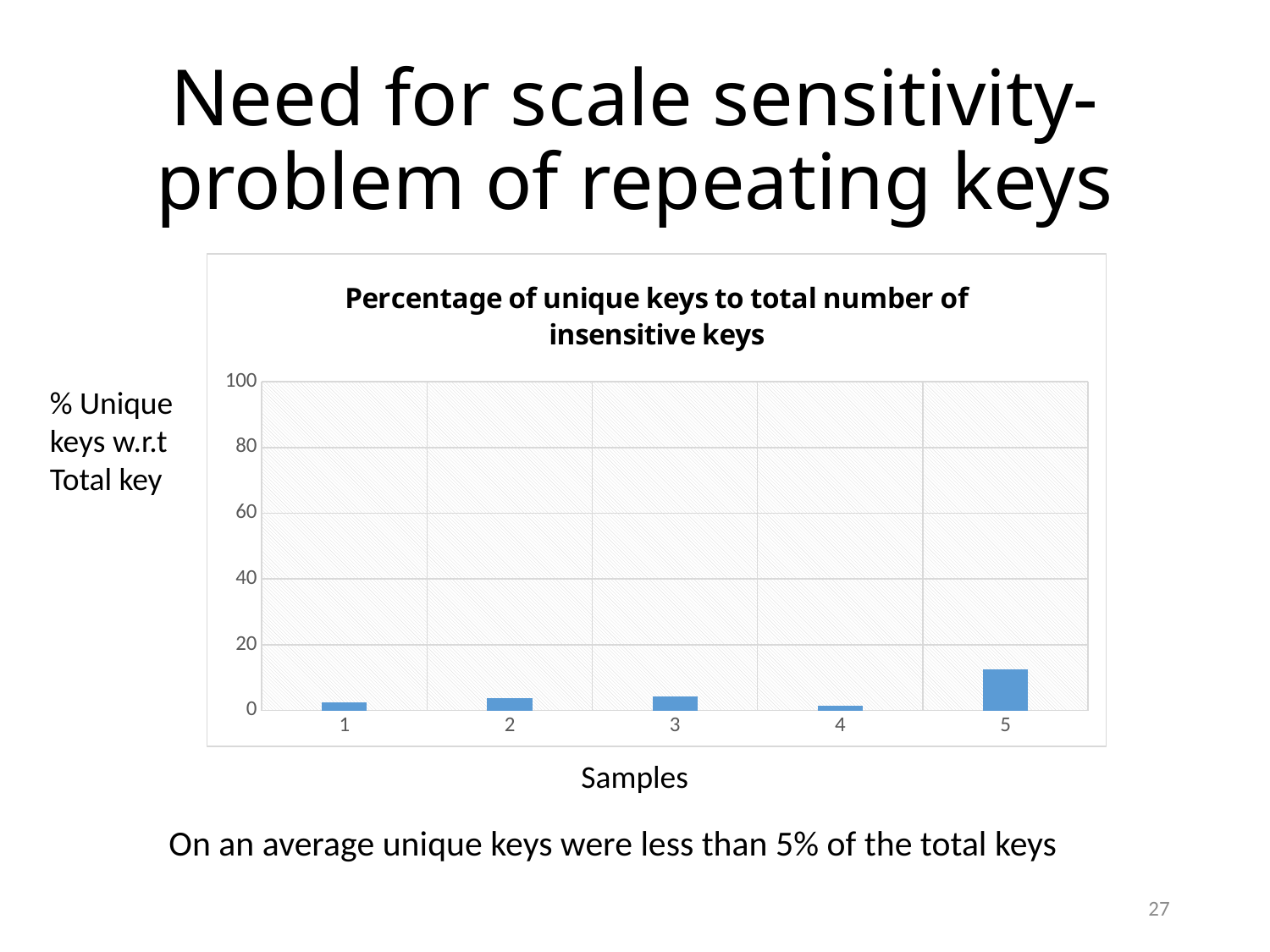
Is the value for sample 3 greater or less than 20? less Which sample has the lowest percentage of unique keys? 4 Which sample has the highest percentage of unique keys? 5 What is the maximum value shown on the y axis? 100 Is the value for sample 5 greater or less than 20? less Is the value for sample 1 greater or less than 20? less Which is larger, the value for sample 5 or the value for sample 3? sample 5 What kind of chart is shown on the slide? bar chart Which is larger, the value for sample 3 or the value for sample 4? sample 3 How many samples (categories) are plotted on the x axis? 5 What is the title of the chart? Percentage of unique keys to total number of insensitive keys